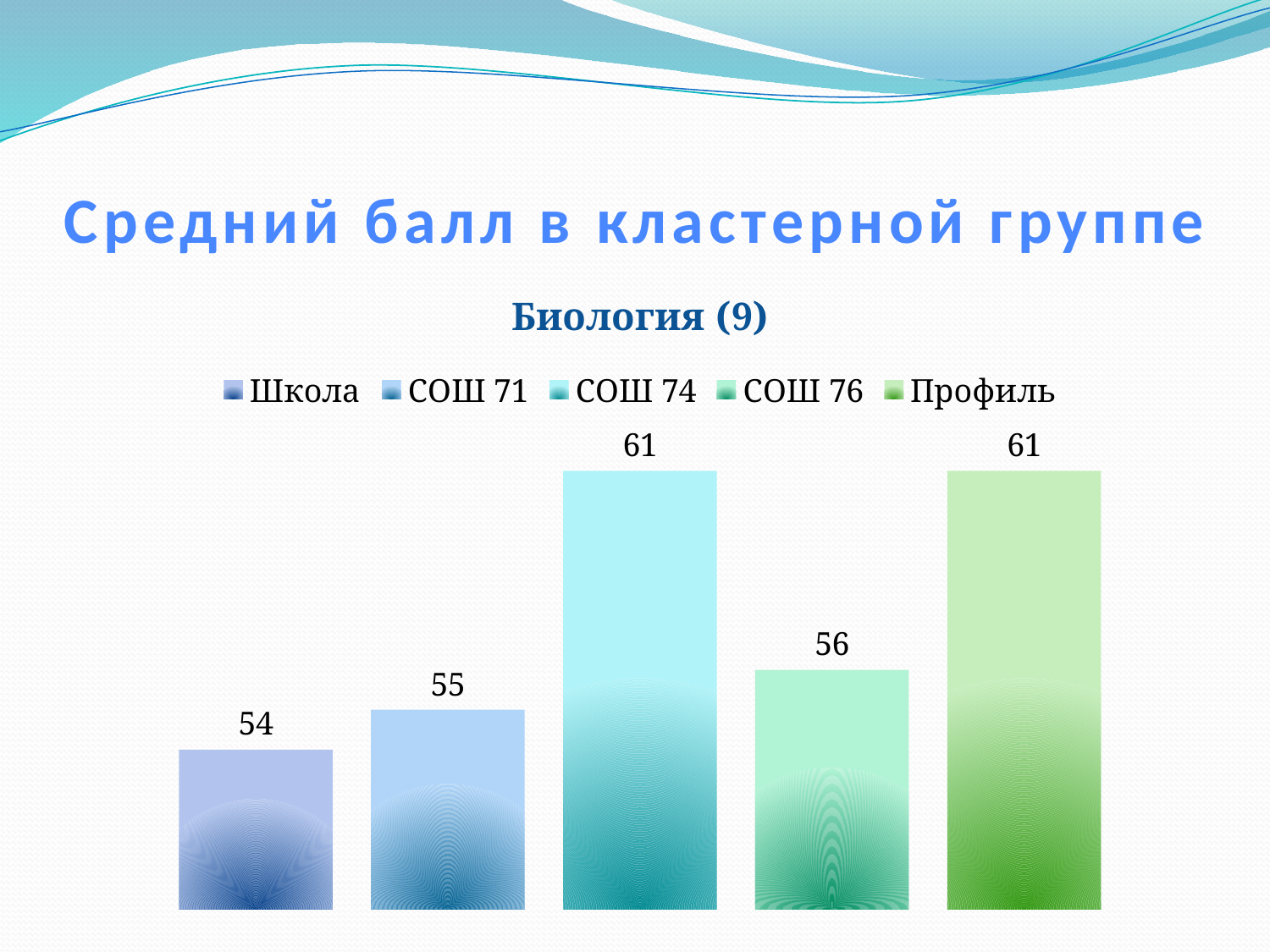
What is the value for СОШ 76? 56 What is the difference between the values for СОШ 74 and Школа? 7 How many bars are plotted in the chart? 5 Which is larger, the value for СОШ 76 or the value for СОШ 71? СОШ 76 What is the value for СОШ 74? 61 Which category has the lowest value? Школа What is the difference between the values for СОШ 76 and СОШ 71? 1 What is the value for Школа? 54 What is the value for Профиль? 61 How many entries does the legend list? 5 What is the value for СОШ 71? 55 What kind of chart is shown on the slide? bar chart